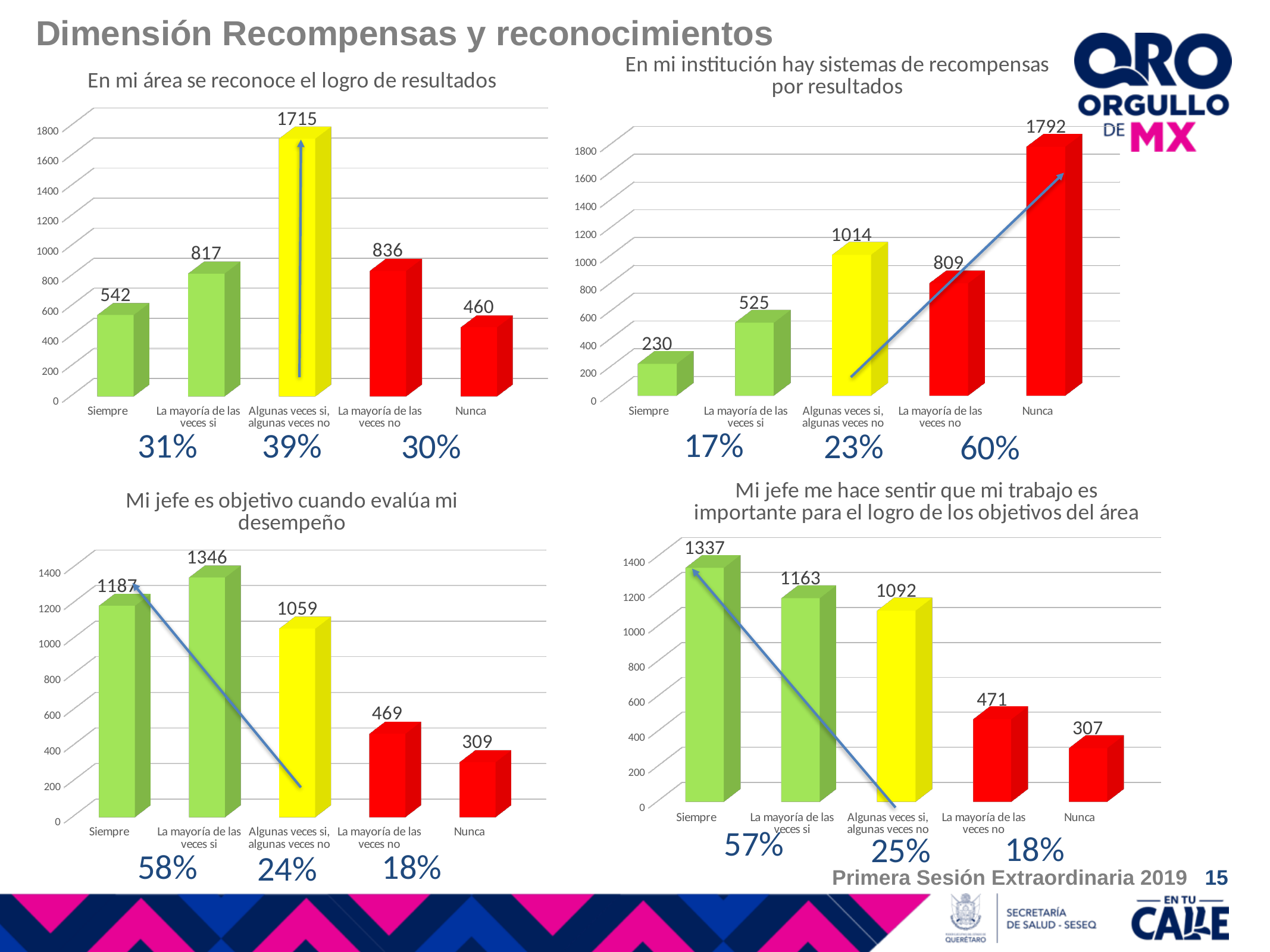
In the chart titled "En mi institución hay sistemas de recompensas por resultados", what is the value for "Siempre"? 230 In the chart titled "Mi jefe es objetivo cuando evalúa mi desempeño", which is larger, the value for "Siempre" or the value for "Algunas veces si, algunas veces no"? Siempre What kind of chart is the chart titled "En mi área se reconoce el logro de resultados"? Bar chart In the chart titled "Mi jefe me hace sentir que mi trabajo es importante para el logro de los objetivos del área", what is the value for "Nunca"? 307 In the chart titled "En mi área se reconoce el logro de resultados", what is the value for "Algunas veces si, algunas veces no"? 1715 In the chart titled "En mi área se reconoce el logro de resultados", which category has the lowest value? Nunca How many categories are shown on the x axis of the chart titled "Mi jefe es objetivo cuando evalúa mi desempeño"? 5 In the chart titled "Mi jefe me hace sentir que mi trabajo es importante para el logro de los objetivos del área", do the values rise or fall from "Siempre" to "Nunca"? Fall In the chart titled "Mi jefe es objetivo cuando evalúa mi desempeño", what is the value for "La mayoría de las veces si"? 1346 In the chart titled "En mi institución hay sistemas de recompensas por resultados", what is the difference between the values for "Nunca" and "Algunas veces si, algunas veces no"? 778 In the chart titled "Mi jefe me hace sentir que mi trabajo es importante para el logro de los objetivos del área", what is the difference between the values for "Siempre" and "La mayoría de las veces si"? 174 In the chart titled "En mi institución hay sistemas de recompensas por resultados", which category has the highest value? Nunca